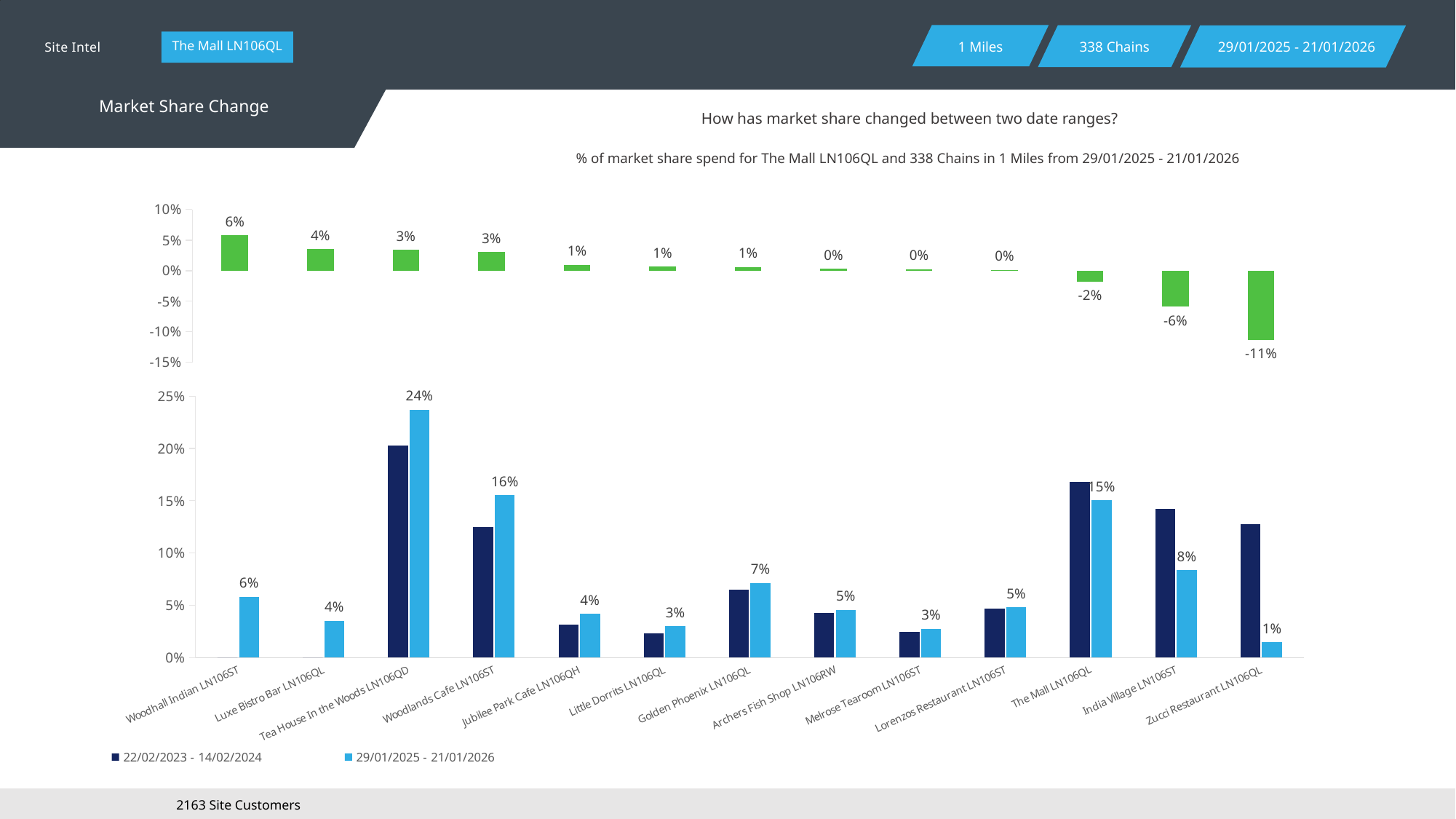
In the top chart (market share change), which category has the highest value? Woodhall Indian LN106ST In the top chart (market share change), what is the value for Woodhall Indian LN106ST? 6% How many series does the legend of the bottom chart list? 2 In the bottom chart, what is the value for Tea House In the Woods LN106QD in the 29/01/2025 - 21/01/2026 series? 24% How many categories are shown on the x axis of the bottom chart? 13 In the bottom chart, what is the difference between Tea House In the Woods LN106QD and Woodlands Cafe LN106ST in the 29/01/2025 - 21/01/2026 series? 8% In the bottom chart, is the value for Tea House In the Woods LN106QD in the 22/02/2023 - 14/02/2024 series greater or less than 15%? greater What colour are the bars in the top chart (market share change)? green In the top chart (market share change), what is the value for India Village LN106ST? -6% What kind of chart is the bottom chart? bar chart In the top chart (market share change), which category has the lowest value? Zucci Restaurant LN106QL In the bottom chart, which is larger in the 29/01/2025 - 21/01/2026 series: Golden Phoenix LN106QL or Archers Fish Shop LN106RW? Golden Phoenix LN106QL